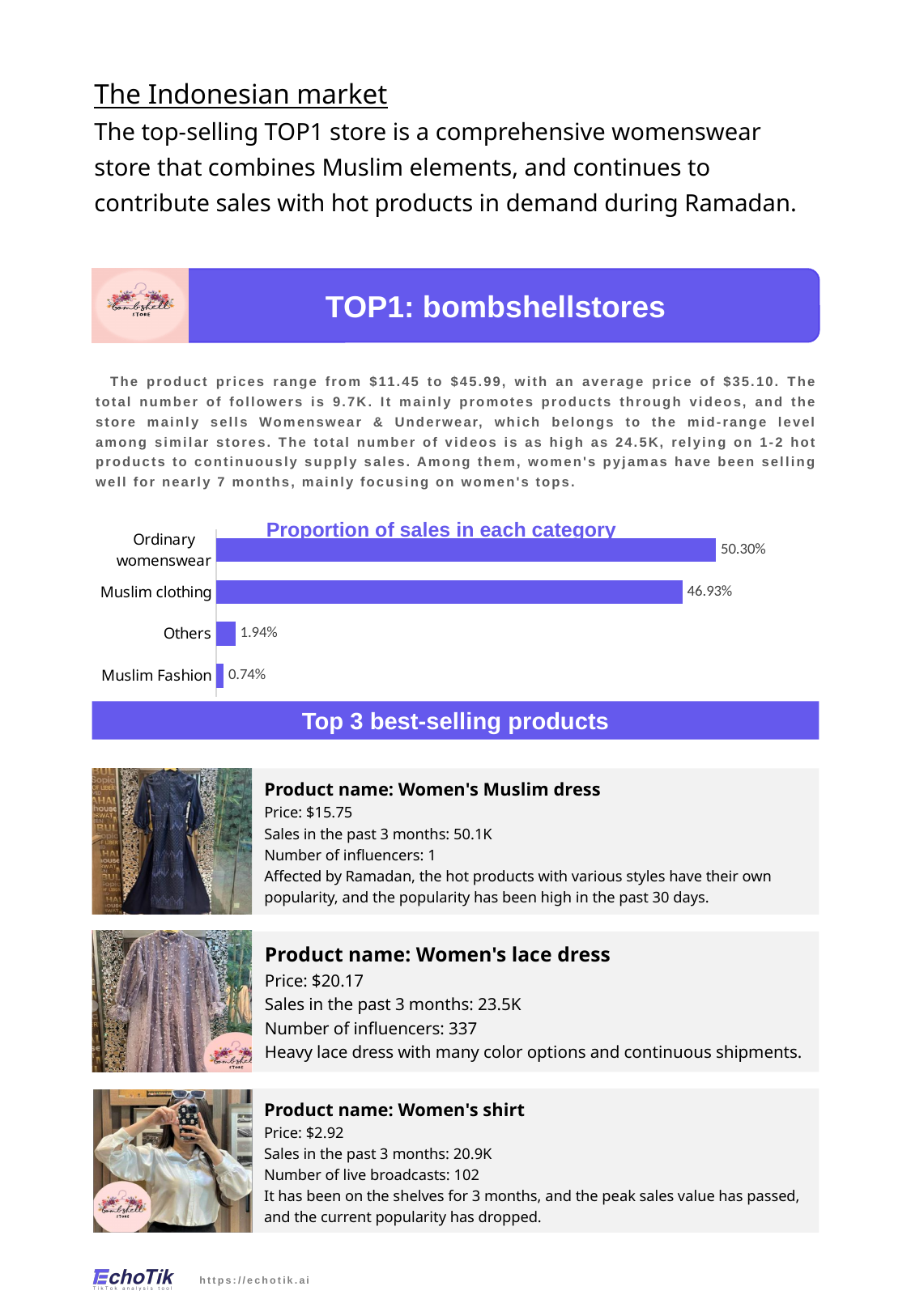
Which category has the lowest proportion of sales in the chart? Muslim Fashion What is the difference between the values for Ordinary womenswear and Muslim clothing in the chart? 3.37% What is the value for Others in the 'Proportion of sales in each category' chart? 1.94% What is the value for Muslim clothing in the 'Proportion of sales in each category' chart? 46.93% What is the value for Ordinary womenswear in the 'Proportion of sales in each category' chart? 50.30% What is the title of the chart on the slide? Proportion of sales in each category What kind of chart is 'Proportion of sales in each category'? Bar chart What is the value for Muslim Fashion in the 'Proportion of sales in each category' chart? 0.74% Which category has the highest proportion of sales in the chart? Ordinary womenswear How many categories are shown in the 'Proportion of sales in each category' chart? 4 What is the difference between the values for Others and Muslim Fashion in the chart? 1.20% Which is larger in the chart: the value for Others or the value for Muslim Fashion? Others